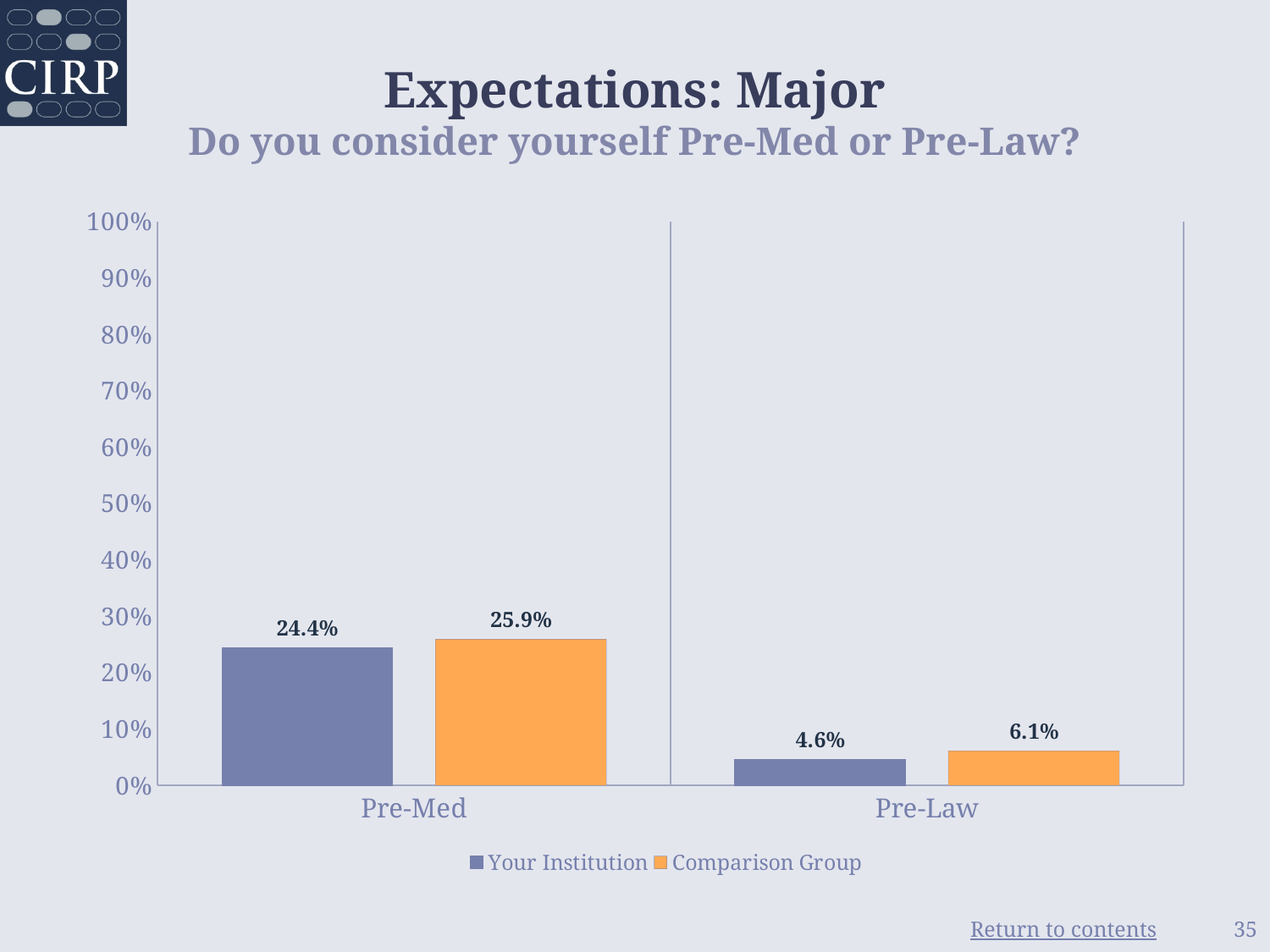
What type of chart is shown on the slide? Bar chart What percentage of Your Institution students consider themselves Pre-Med? 24.4% Which category has the highest value for the Comparison Group? Pre-Med What is the difference between the Comparison Group and Your Institution values for Pre-Med? 1.5% What is the Your Institution value for Pre-Law? 4.6% Which category has the lowest value for Your Institution? Pre-Law How many series does the legend list? 2 What is the Comparison Group value for Pre-Law? 6.1% What is the Comparison Group value for Pre-Med? 25.9% What is the difference between the Comparison Group and Your Institution values for Pre-Law? 1.5% For Pre-Law, which is larger: Your Institution or Comparison Group? Comparison Group Is the Your Institution value for Pre-Med greater or less than 30%? less